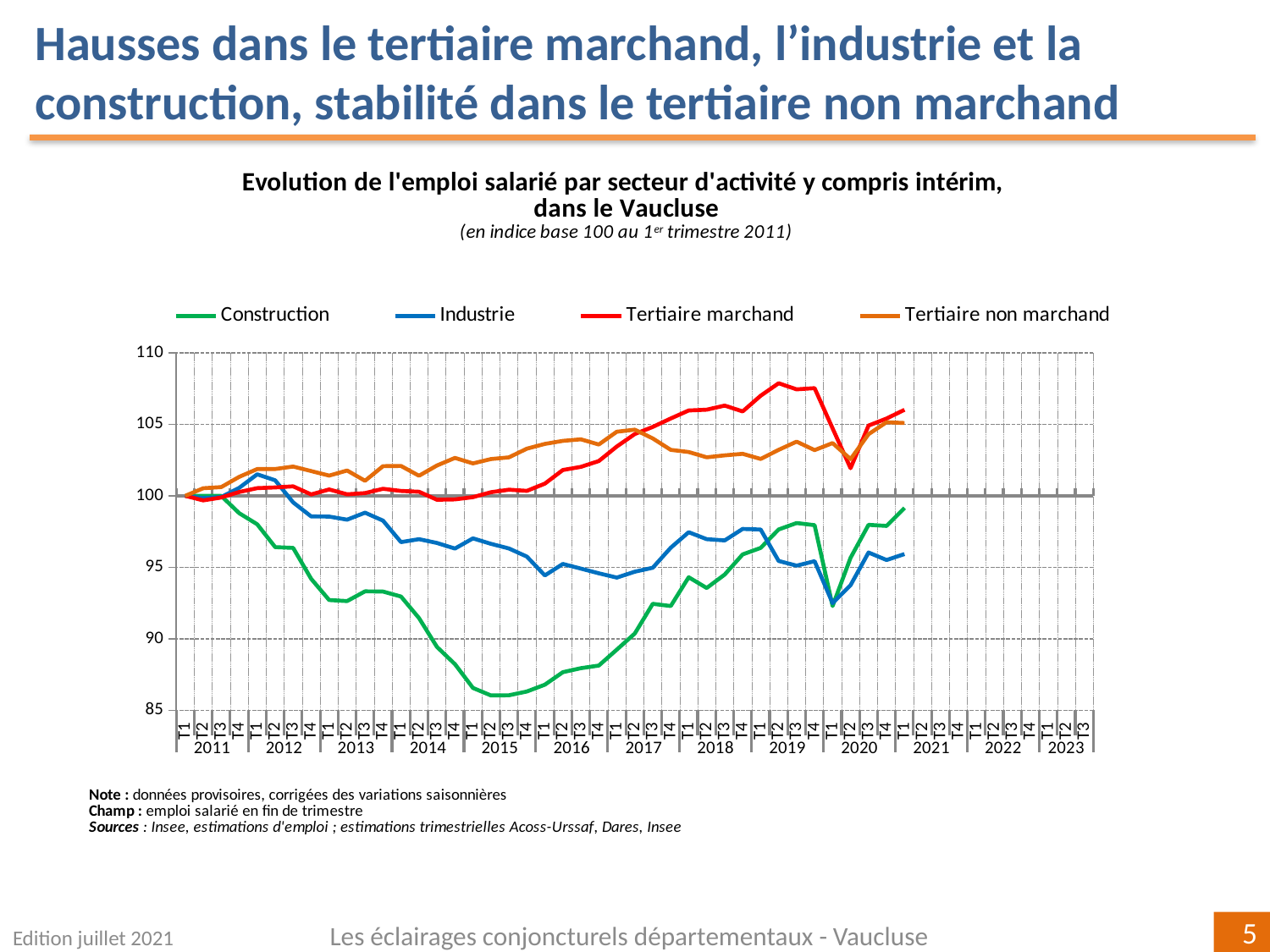
Is the value for Industrie at T1 2020 greater or less than 95? less Is the value for Tertiaire marchand at T2 2019 greater or less than 105? greater At T1 2016, which is larger: Industrie or Construction? Industrie Is the value for Construction at T1 2015 greater or less than 90? less Which series are listed in the legend? Construction, Industrie, Tertiaire marchand, Tertiaire non marchand Which series has the lowest value at T1 2015? Construction Which series has the highest value at T2 2019? Tertiaire marchand How many series does the legend list? 4 Does the Construction series rise or fall between T1 2011 and T1 2015? fall What kind of chart is shown on the slide? line chart What is the index value of the Construction series at T1 2011? 100 Does the Tertiaire marchand series rise or fall between T1 2015 and T2 2019? rise